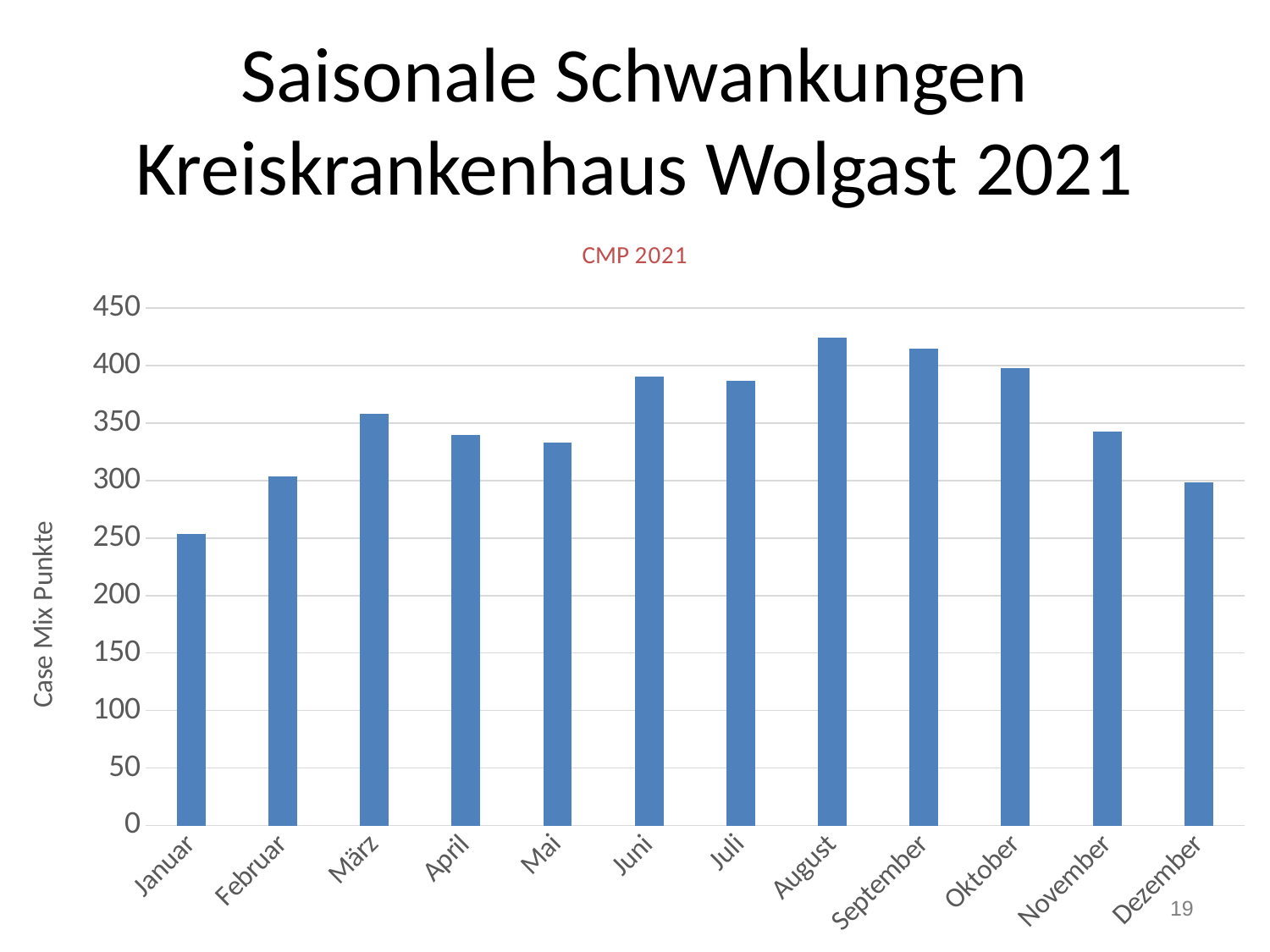
How many months (categories) are plotted on the x axis? 12 Is the value for August greater or less than 400? greater Which month has the highest Case Mix Punkte value? August Is the value for November greater or less than 350? less Which is larger, the value for März or the value for April? März What kind of chart is shown on the slide? Bar chart Which month has the lowest Case Mix Punkte value? Januar Do the values rise or fall from August to Dezember? fall Which is larger, the value for Januar or the value for Dezember? Dezember Is the value for März greater or less than 350? greater What is the label on the vertical axis of the chart? Case Mix Punkte